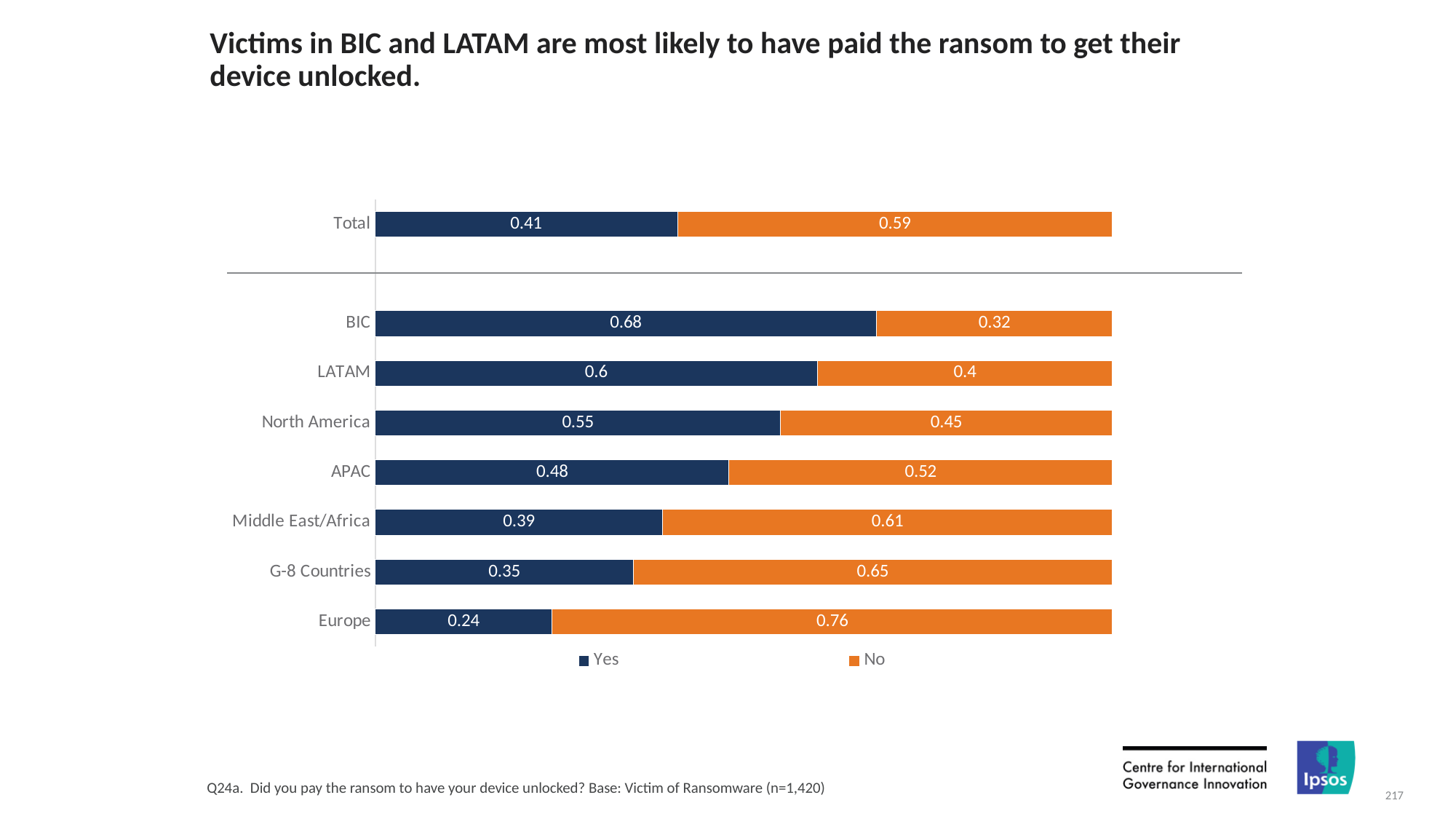
What is the Yes value for BIC? 0.68 What kind of chart is shown on the slide? Stacked bar chart What is the difference between the Yes values for BIC and Europe? 0.44 Which is larger, the Yes value for LATAM or the Yes value for North America? LATAM Which category has the highest Yes value? BIC Which category has the lowest Yes value? Europe What is the No value for Europe? 0.76 What is the No value for APAC? 0.52 How many series does the legend list? 2 How many categories are shown on the chart, including Total? 8 What is the Yes value for Total? 0.41 What is the total of the stacked bar for G-8 Countries? 1